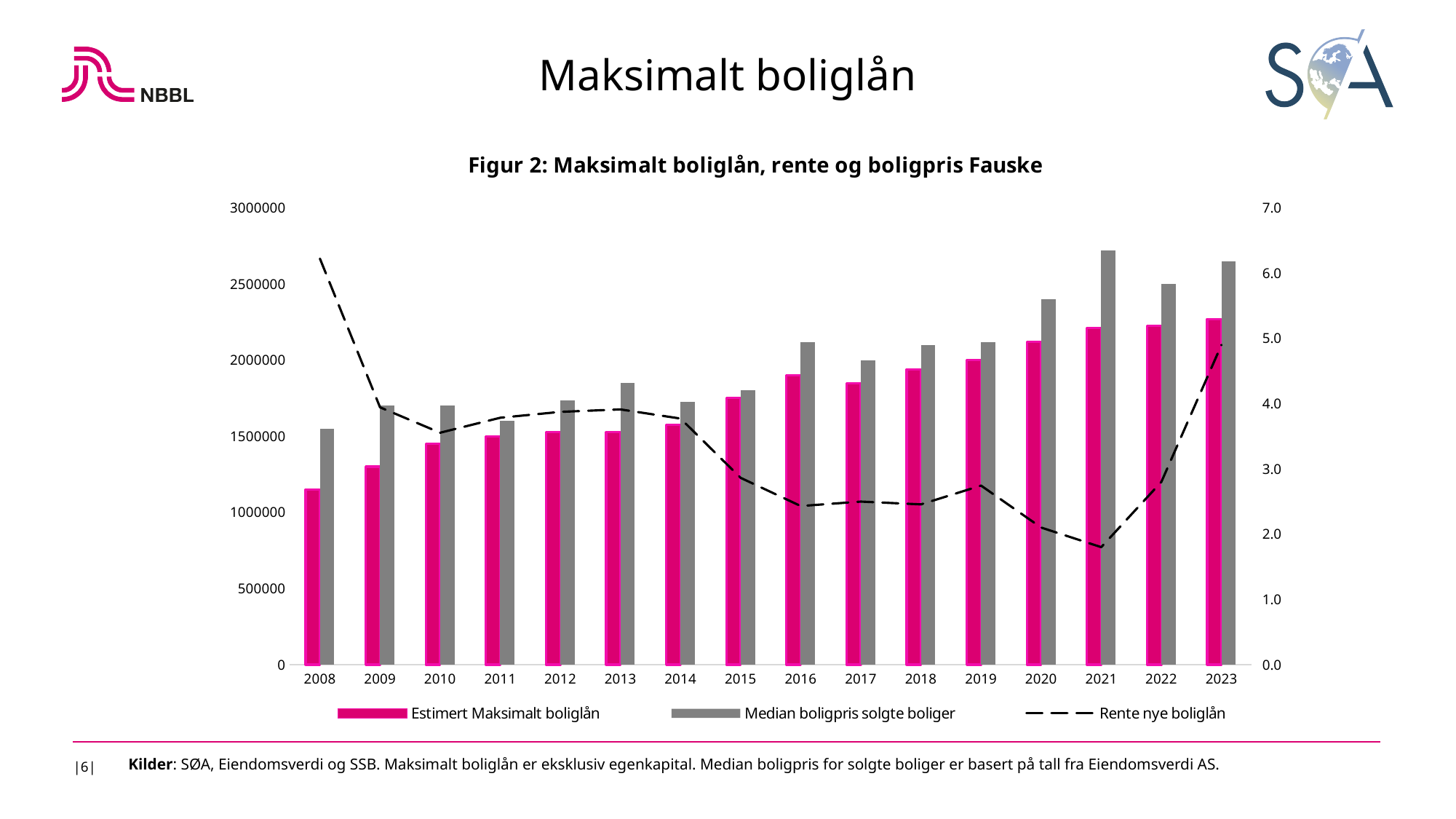
How many series does the legend list? 3 Is the value for Median boligpris solgte boliger in 2021 greater or less than 2500000? greater In which year is Median boligpris solgte boliger highest? 2021 Does Estimert Maksimalt boliglån generally rise or fall from 2008 to 2023? rise In which year is Rente nye boliglån highest? 2008 In 2023, which is larger: Estimert Maksimalt boliglån or Median boligpris solgte boliger? Median boligpris solgte boliger In which year is Rente nye boliglån lowest? 2021 In which year is Estimert Maksimalt boliglån lowest? 2008 What kind of chart is shown on the slide? bar chart with a line How many years are shown on the x axis? 16 Is the value for Estimert Maksimalt boliglån in 2008 greater or less than 1500000? less Is the value for Rente nye boliglån in 2023 greater or less than 4.0? greater